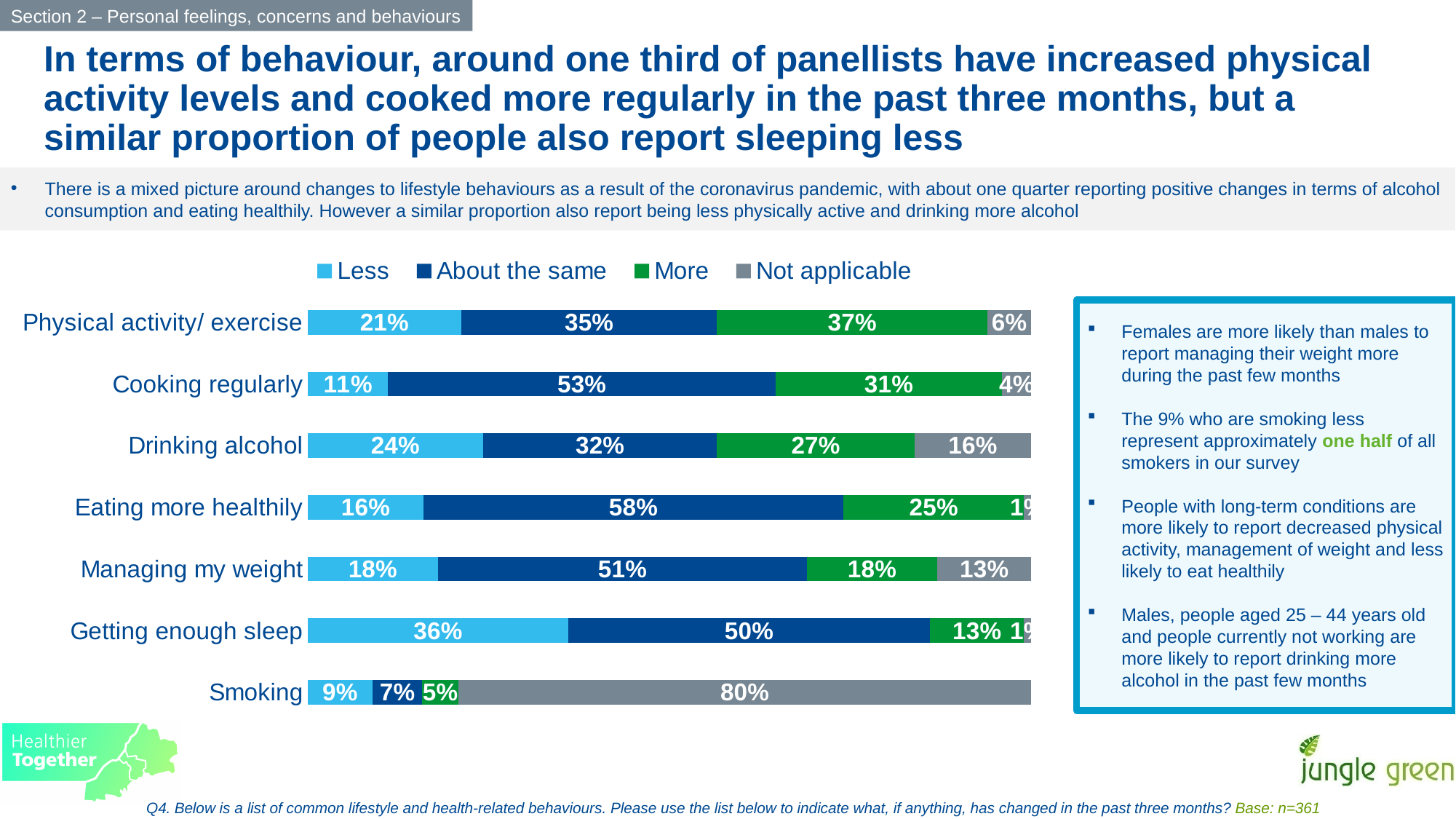
Which legend entry is shown in green? More How many series does the legend list? 4 What kind of chart is shown on the slide? Stacked bar chart How many behaviour categories are plotted in the chart? 7 What is the 'Less' value for Getting enough sleep? 36% What percentage of panellists report doing 'More' physical activity/ exercise? 37% What is the 'Not applicable' value for Smoking? 80% Which category has the lowest 'More' value? Smoking What is the 'About the same' value for Eating more healthily? 58% What is the difference between the 'More' and 'Less' values for Drinking alcohol? 3% Which is larger for Cooking regularly: the 'More' value or the 'Less' value? More Which category has the highest 'Less' value? Getting enough sleep